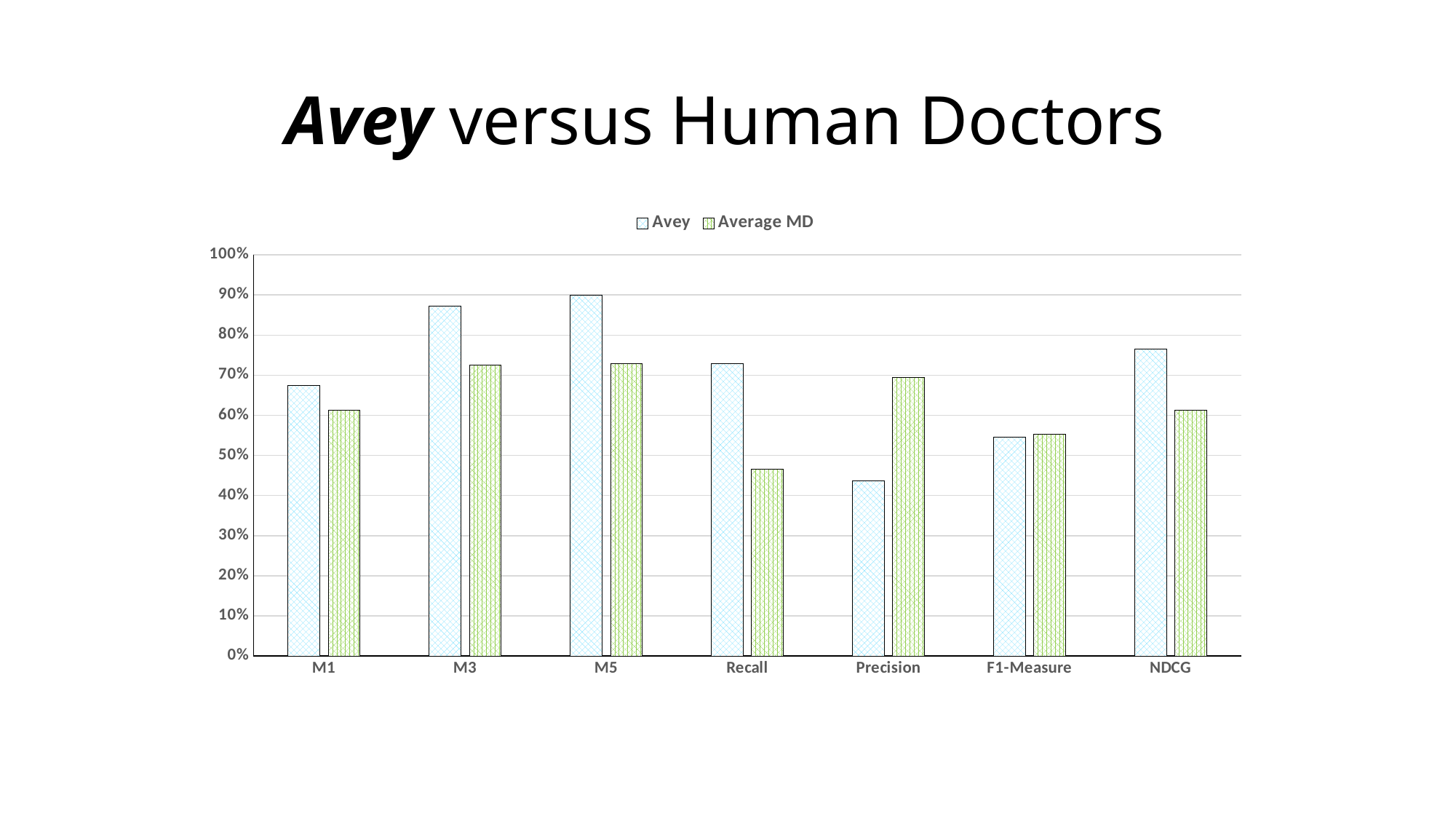
Which category has the lowest value for the Average MD series? Recall For Recall, which series has the larger value, Avey or Average MD? Avey What kind of chart is shown on the slide? bar chart Is the Avey value for Precision greater or less than 50%? less For Precision, which series has the larger value, Avey or Average MD? Average MD How many categories are shown on the x axis? 7 How many series does the legend list? 2 Is the Average MD value for Recall greater or less than 50%? less Is the Avey value for M5 greater or less than 80%? greater Which category has the highest value for the Avey series? M5 Which category has the lowest value for the Avey series? Precision What are the two series named in the legend? Avey and Average MD